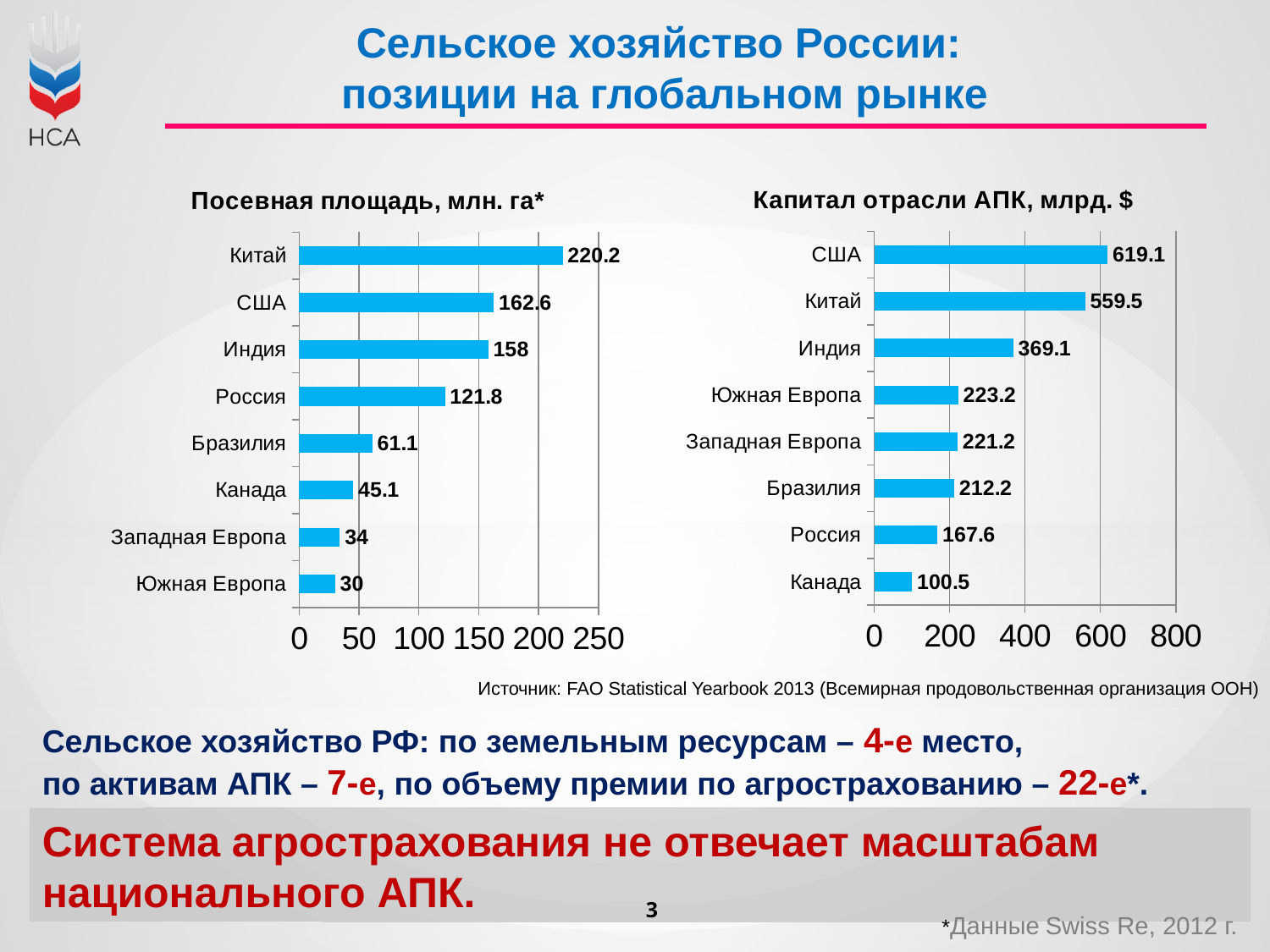
In the chart 'Посевная площадь, млн. га*', which category has the highest value? Китай In the chart 'Посевная площадь, млн. га*', what is the value for Россия? 121.8 In the chart 'Посевная площадь, млн. га*', is the value for Индия greater or less than 150? greater In the chart 'Посевная площадь, млн. га*', what is the value for Южная Европа? 30 In the chart 'Капитал отрасли АПК, млрд. $', which category has the lowest value? Канада What kind of chart is 'Посевная площадь, млн. га*'? bar chart In the chart 'Посевная площадь, млн. га*', what is the difference between the values for Китай and США? 57.6 How many categories are shown in the chart 'Капитал отрасли АПК, млрд. $'? 8 In the chart 'Капитал отрасли АПК, млрд. $', what is the difference between the values for США and Россия? 451.5 In the chart 'Капитал отрасли АПК, млрд. $', which is larger: the value for Южная Европа or Бразилия? Южная Европа In the chart 'Капитал отрасли АПК, млрд. $', what is the value for Индия? 369.1 What is the title of the chart on the right side of the slide? Капитал отрасли АПК, млрд. $